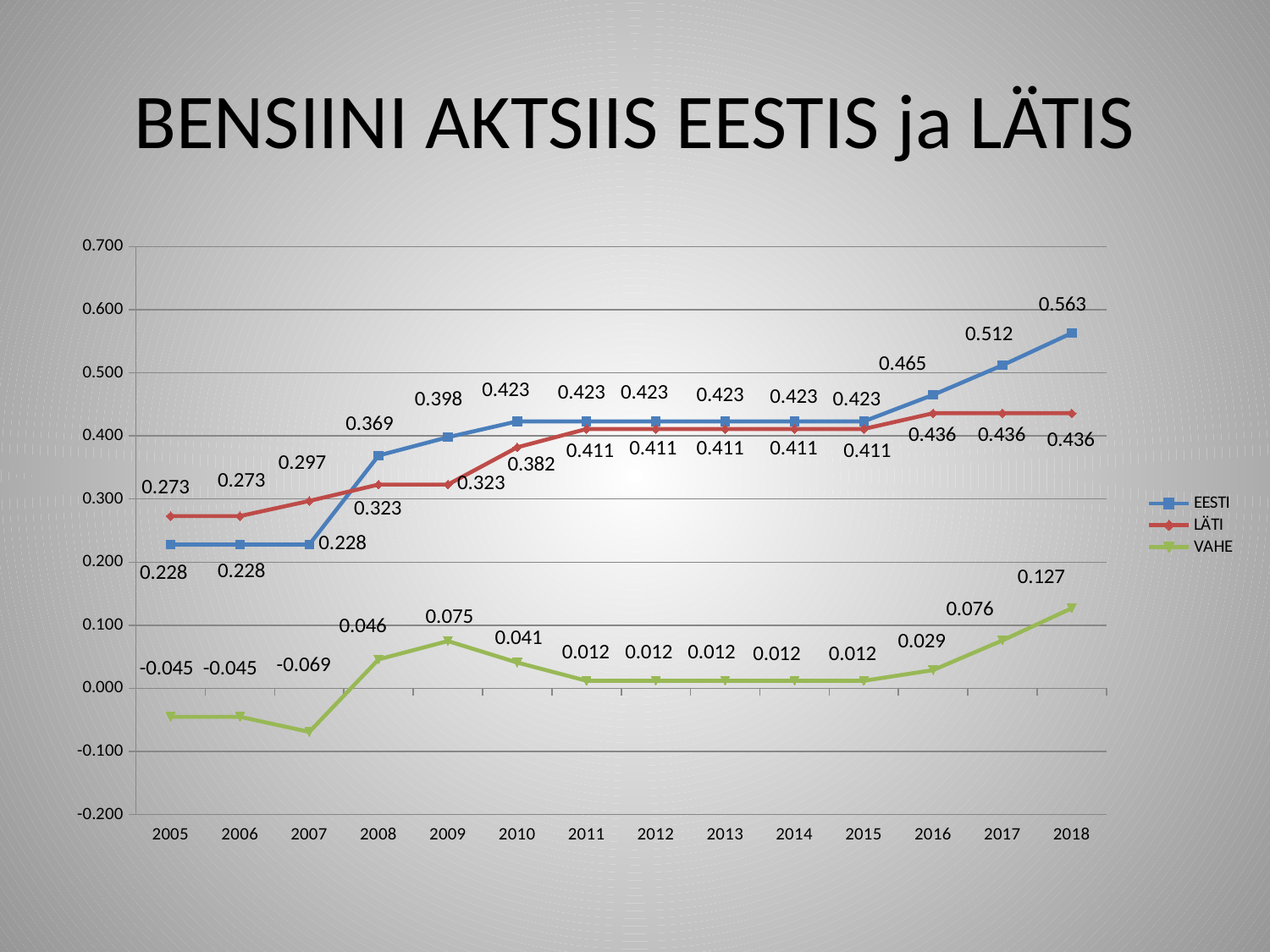
What kind of chart is shown on the slide? Line chart What is the value for EESTI in 2018? 0.563 What is the difference between the EESTI and LÄTI values in 2018? 0.127 What is the value for VAHE in 2007? -0.069 How many years are shown on the x axis? 14 Does the EESTI series rise or fall from 2015 to 2018? Rise What is the value for LÄTI in 2010? 0.382 How many series does the legend list? 3 What is the title of the chart on the slide? BENSIINI AKTSIIS EESTIS ja LÄTIS In which year does the EESTI series reach its highest value? 2018 In which year is the VAHE series at its lowest value? 2007 Which series has the larger value in 2006, EESTI or LÄTI? LÄTI